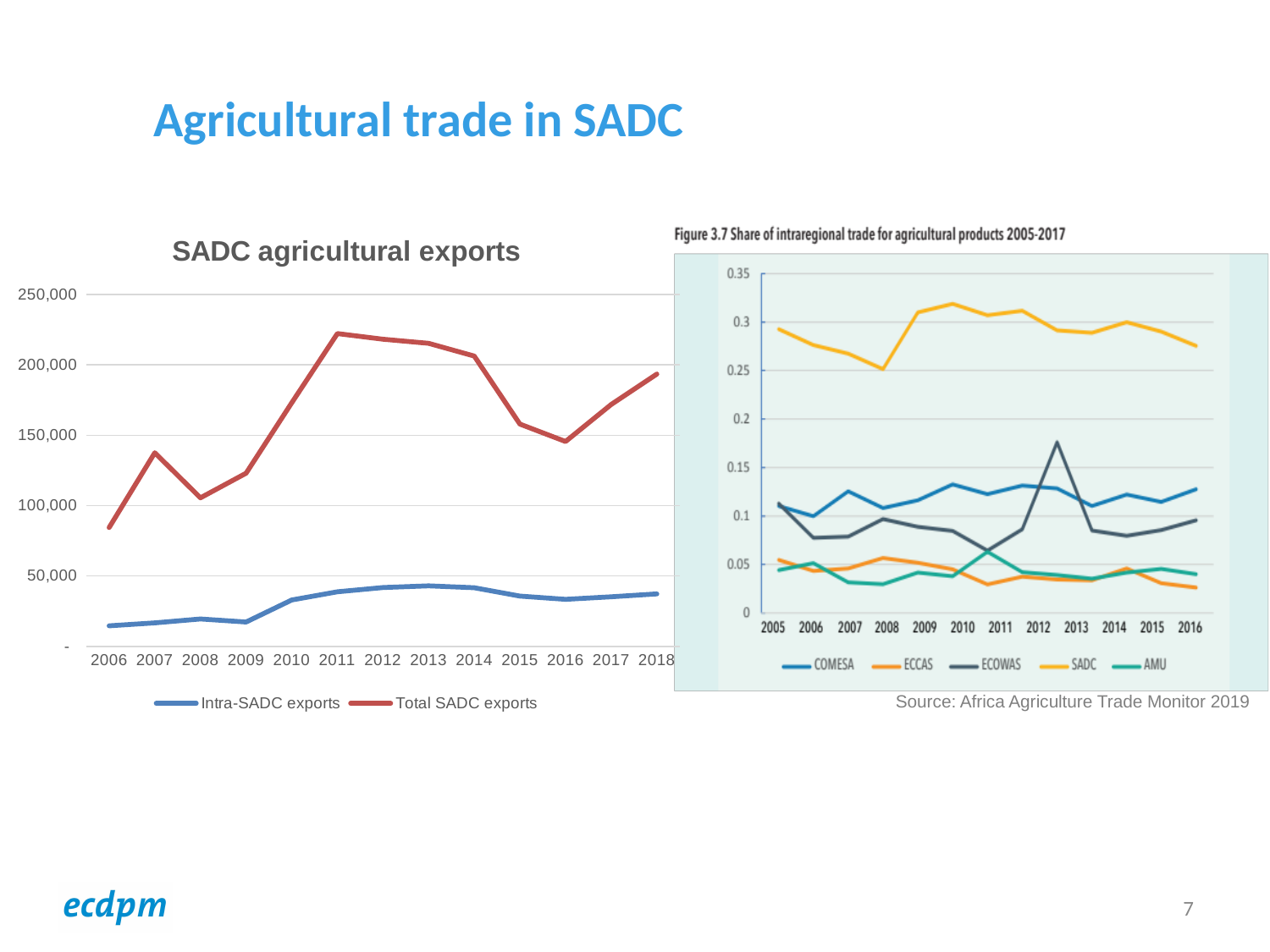
What type of chart is the 'SADC agricultural exports' chart? line chart In the 'SADC agricultural exports' chart, is the value for Total SADC exports in 2006 greater or less than 100,000? less In the 'SADC agricultural exports' chart, which is larger: Total SADC exports in 2011 or in 2016? 2011 In the 'SADC agricultural exports' chart, do Intra-SADC exports rise or fall from 2006 to 2011? rise How many years are shown on the x axis of the 'SADC agricultural exports' chart? 13 In the 'Figure 3.7 Share of intraregional trade for agricultural products 2005-2017' chart, is the value for ECCAS in 2011 greater or less than 0.05? less In the 'Figure 3.7 Share of intraregional trade for agricultural products 2005-2017' chart, which series has the highest values across the period? SADC How many series does the legend of the 'SADC agricultural exports' chart list? 2 How many series does the legend of the 'Figure 3.7 Share of intraregional trade for agricultural products 2005-2017' chart list? 5 In the 'SADC agricultural exports' chart, is the value for Intra-SADC exports in 2013 greater or less than 50,000? less